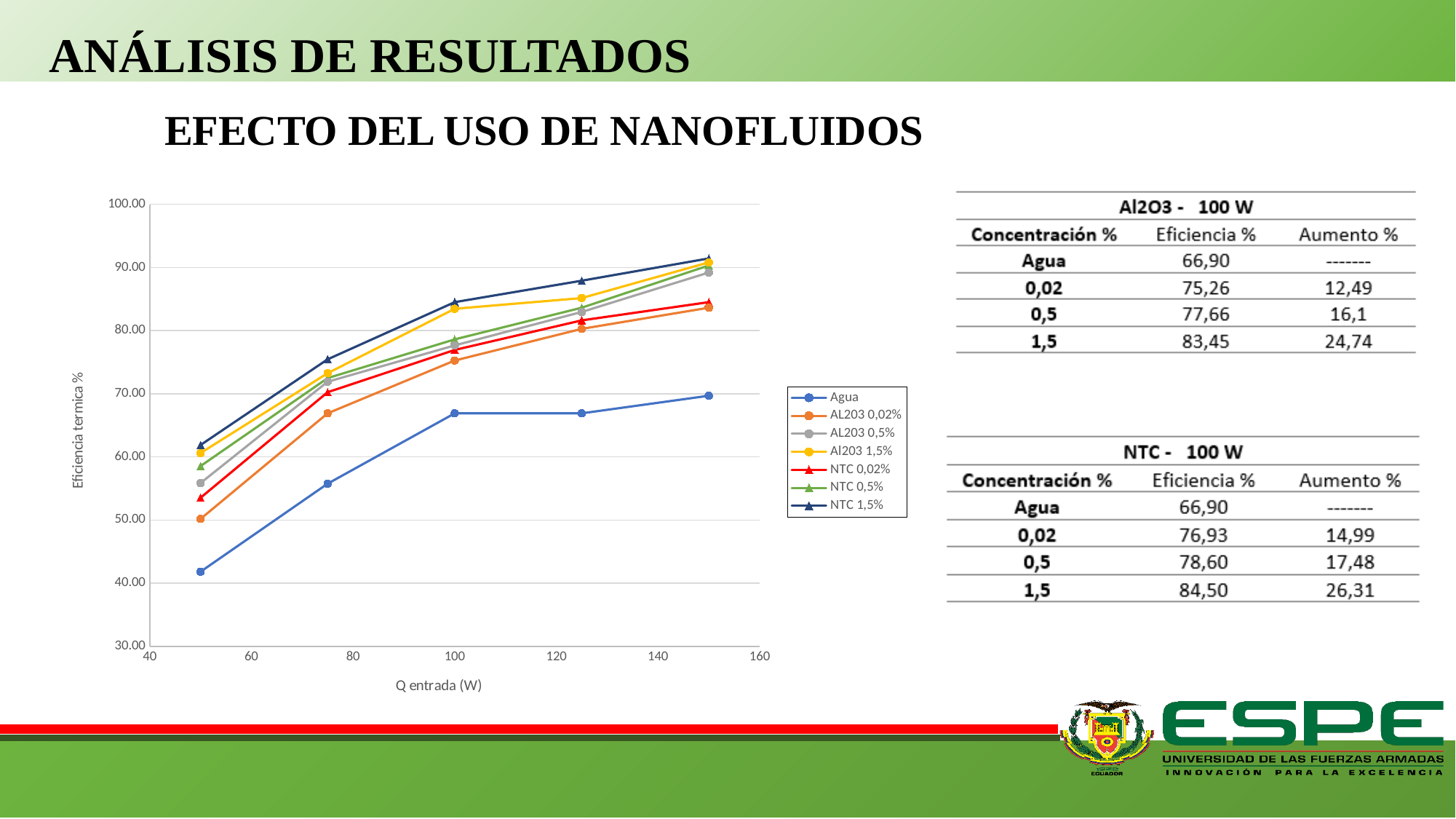
Does the thermal efficiency of the NTC 1,5% series rise or fall as Q entrada increases? rise How many data points does the Agua series have? 5 Which series has the lowest thermal efficiency across the chart? Agua Which series has the highest thermal efficiency at 150 W? NTC 1,5% Is the value for Agua at 100 W greater or less than 70? less How many series does the chart legend list? 7 What is the label of the x axis of the chart? Q entrada (W) At 50 W, which is larger: the value for Agua or the value for AL2O3 0,02%? AL2O3 0,02% Is the value for NTC 1,5% at 150 W greater or less than 90? greater Is the value for NTC 1,5% at 100 W greater or less than 80? greater What kind of chart is shown on the slide? line chart